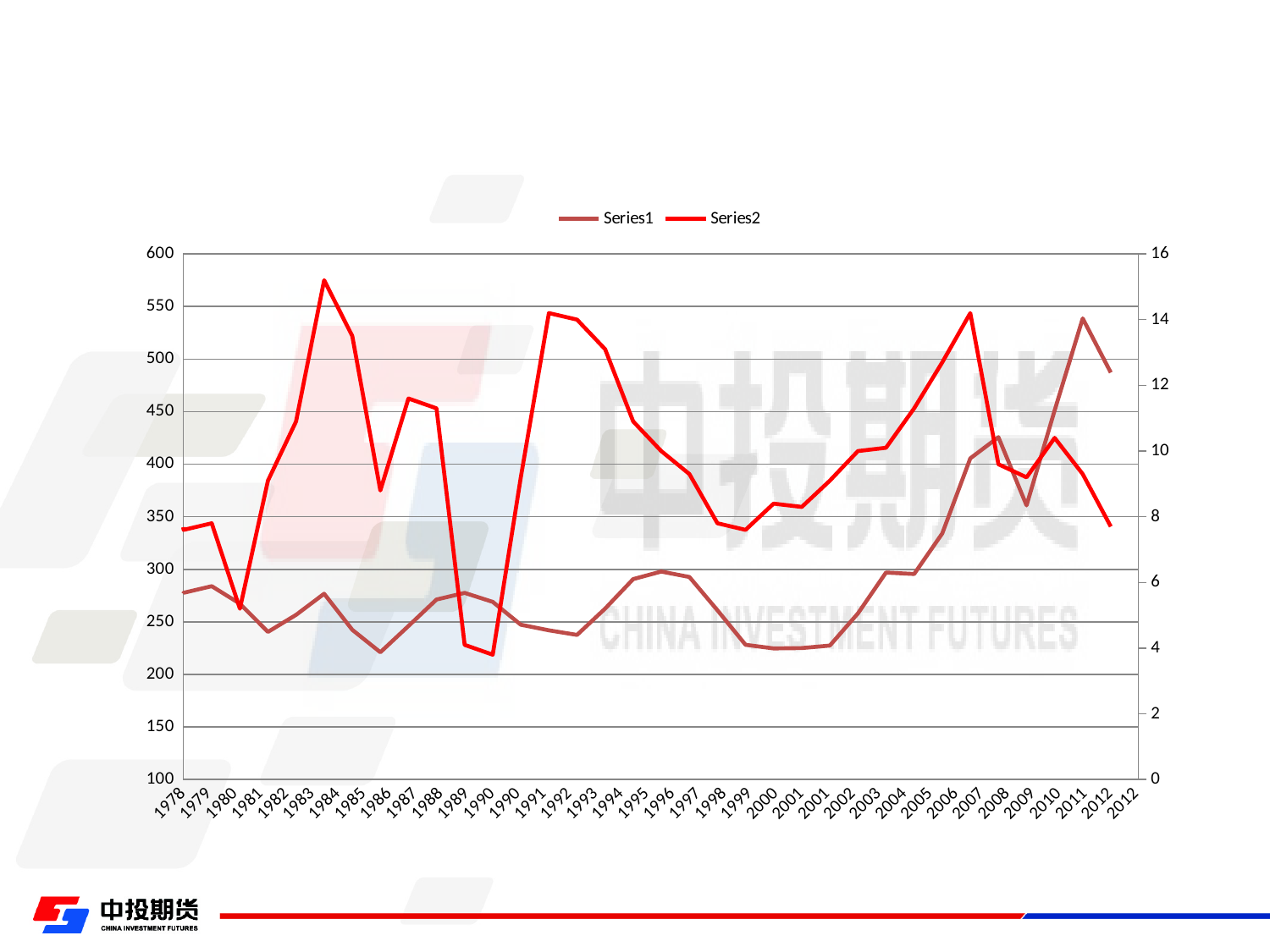
What kind of chart is shown on the slide? line chart In which year does Series2 reach its highest point? 1984 Is the value for Series2 in 1990, read on the right axis, greater or less than 6? less Is the value for Series2 in 1984, read on the right axis, greater or less than 14? greater Does Series1 rise or fall between 2001 and 2007? rise What is the highest value shown on the left vertical axis? 600 Which is higher for Series1: the value in 2011 or the value in 1978? 2011 Is the value for Series1 in 2011, read on the left axis, greater or less than 500? greater How many series does the legend list? 2 In which year does Series1 reach its highest point? 2011 What are the names of the two series in the legend? Series1 and Series2